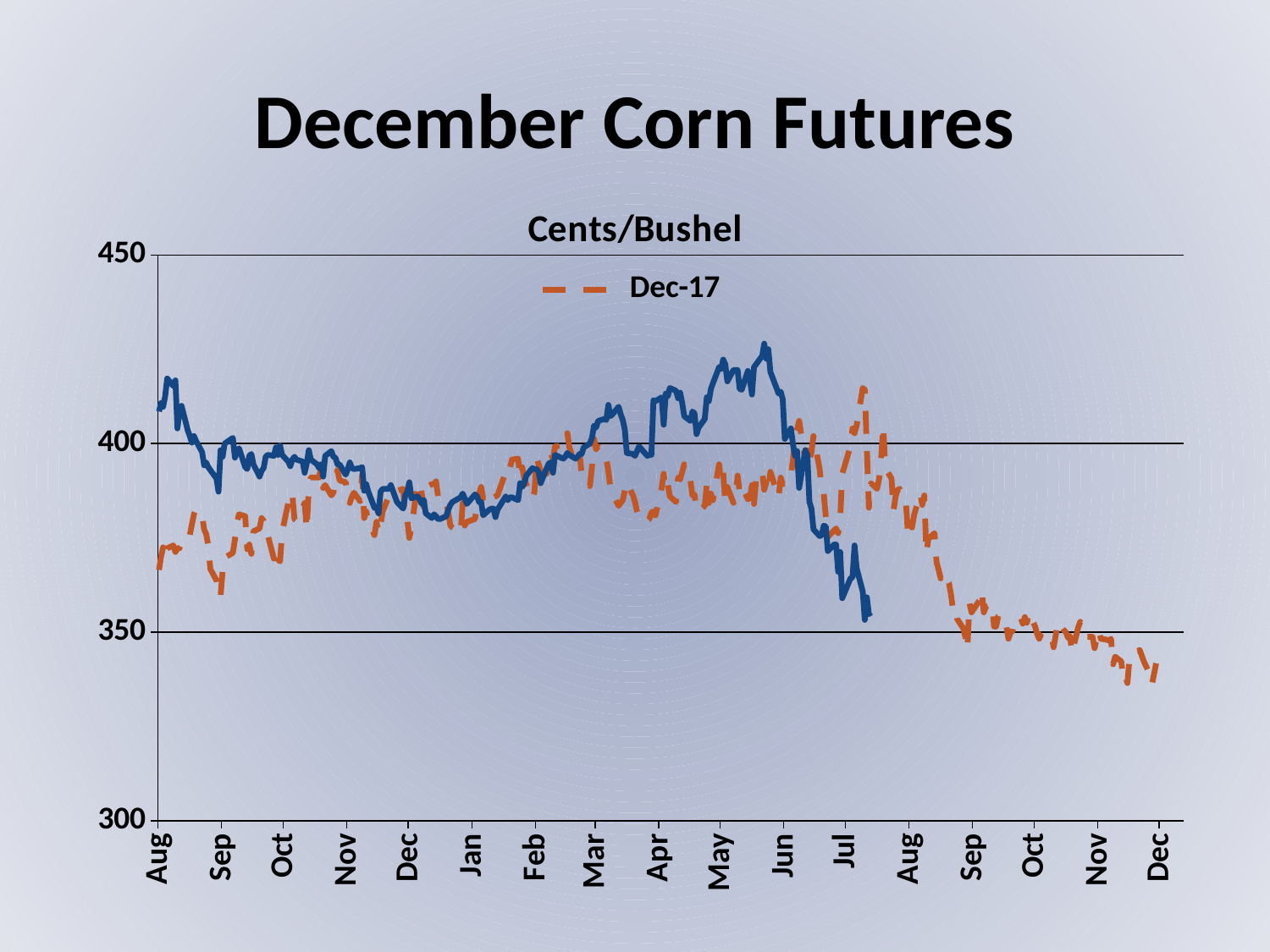
How many month labels are shown along the x axis? 17 Is the Dec-17 value at the final Dec point greater or less than 350? less What series name appears in the chart's legend? Dec-17 What kind of chart is shown on the slide? line chart Which line reaches the lowest value on the chart: the solid blue line or the dashed Dec-17 line? the dashed Dec-17 line How many series does the chart's legend list? 1 Is the highest point of the solid blue line, reached around late May, greater or less than 400? greater Is the Dec-17 value at the first Aug point greater or less than 400? less At the first Aug point, which line is higher: the solid blue line or the dashed Dec-17 line? the solid blue line Overall, does the Dec-17 line rise or fall from the first Aug to the final Dec? fall What is the title of the chart on the slide? Cents/Bushel